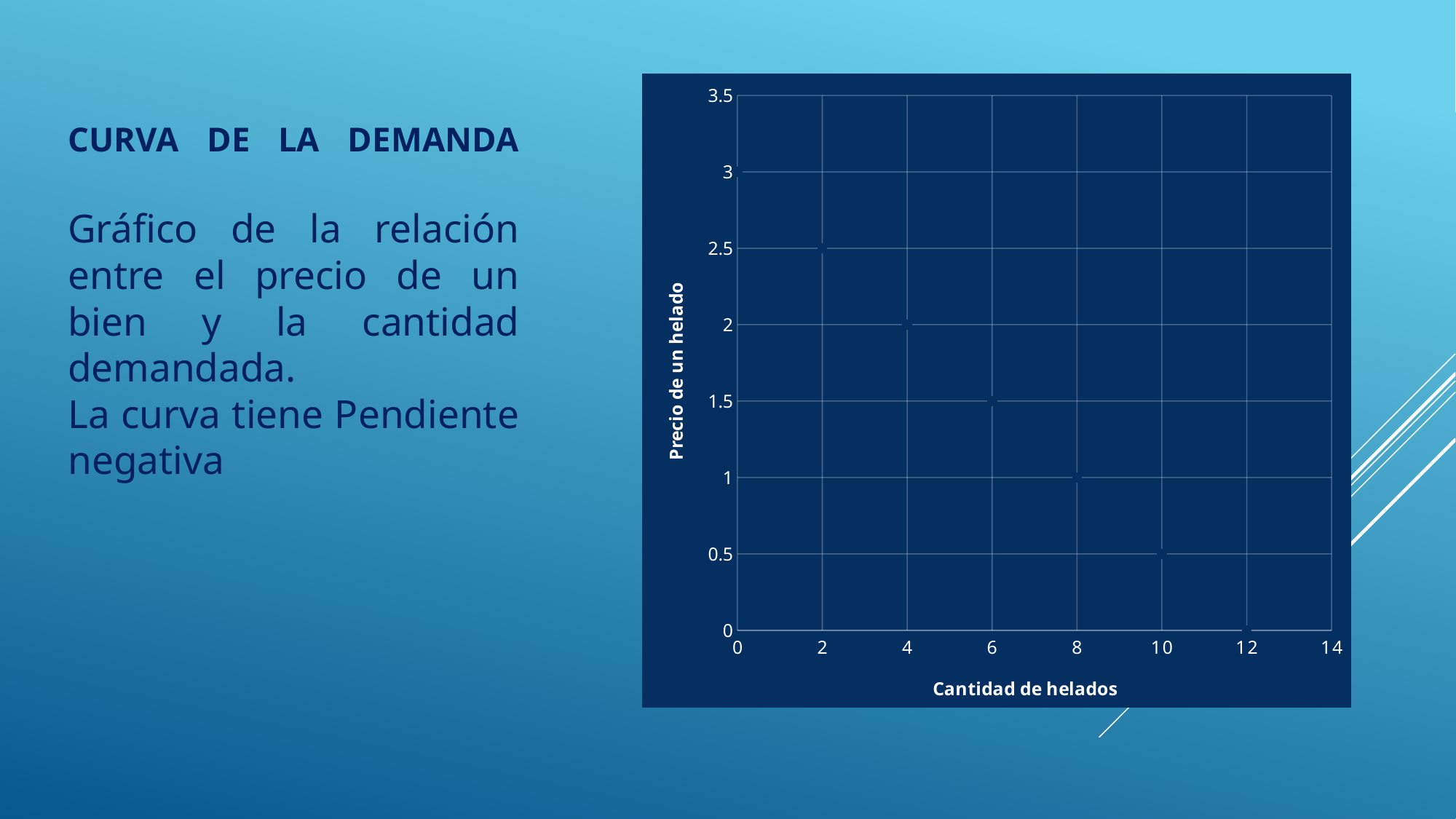
What is the price of an ice cream when the quantity is 12? 0 What kind of chart is shown on the slide? scatter chart How many data points are plotted on the chart? 7 What is the label of the vertical axis of the chart? Precio de un helado At which quantity is the price of an ice cream highest? 0 What is the price of an ice cream when the quantity is 6? 1.5 Which has the higher price: a quantity of 2 or a quantity of 10? 2 What is the label of the horizontal axis of the chart? Cantidad de helados Do the plotted values rise or fall as the quantity of ice creams increases? fall What is the price of an ice cream when the quantity is 0? 3 Is the price at a quantity of 4 greater or less than 1.5? greater At which quantity is the price of an ice cream lowest? 12